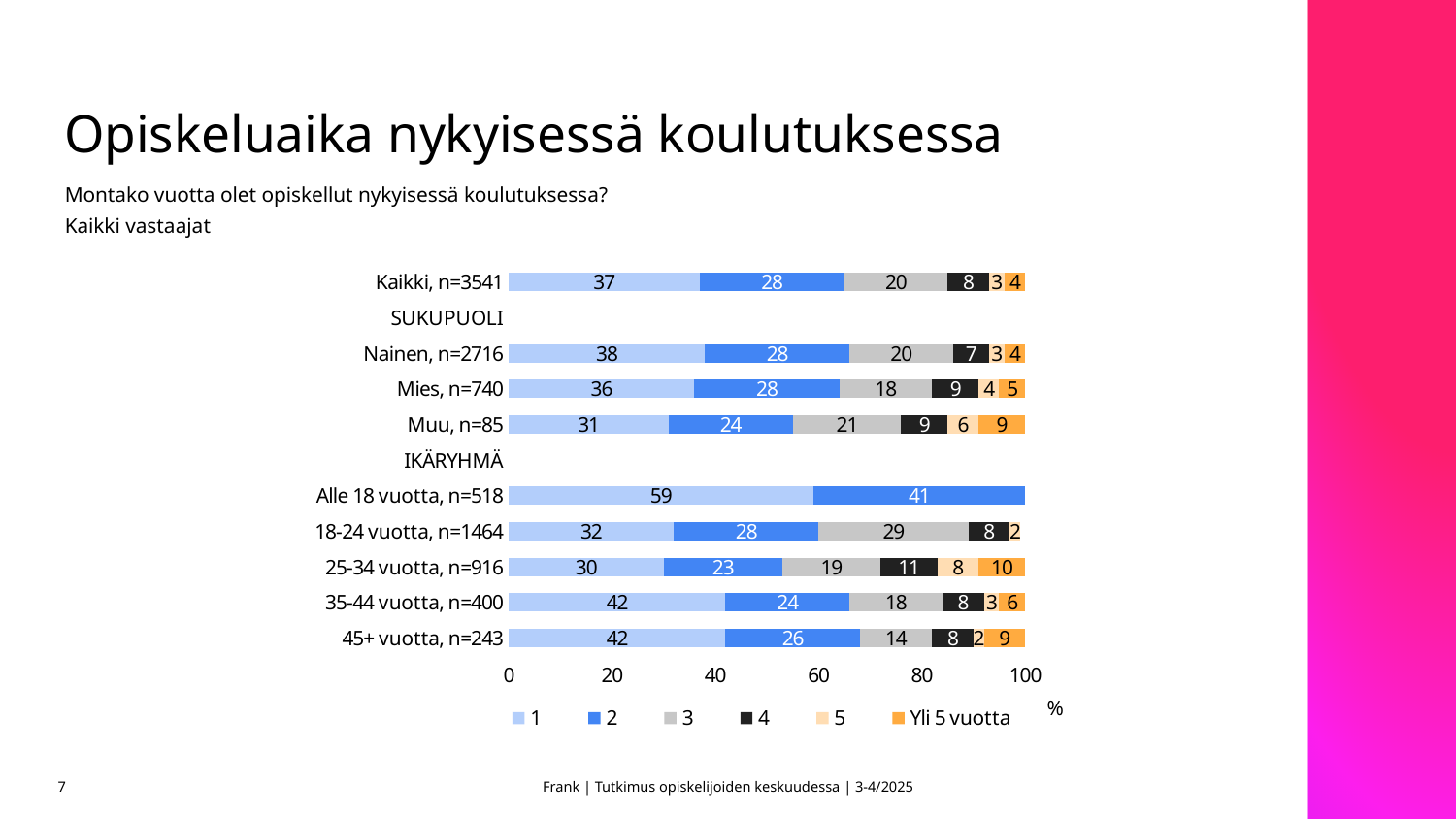
Which category has the highest value in the '1' series? Alle 18 vuotta, n=518 What is the value of the '2' series for Muu, n=85? 24 What kind of chart is shown on the slide? Stacked bar chart What is the value of the '3' series for 45+ vuotta, n=243? 14 What percentage of all respondents (Kaikki, n=3541) have studied 1 year in their current education? 37 How many series does the legend list? 6 What is the value of the 'Yli 5 vuotta' series for 25-34 vuotta, n=916? 10 What is the difference between the '1' series values for Alle 18 vuotta, n=518 and 18-24 vuotta, n=1464? 27 Which category has the lowest value in the '1' series? 25-34 vuotta, n=916 Which has a larger value in the '3' series: Nainen, n=2716 or Mies, n=740? Nainen, n=2716 How many respondent groups (bars) are plotted in the chart? 9 What is the title of the slide? Opiskeluaika nykyisessä koulutuksessa